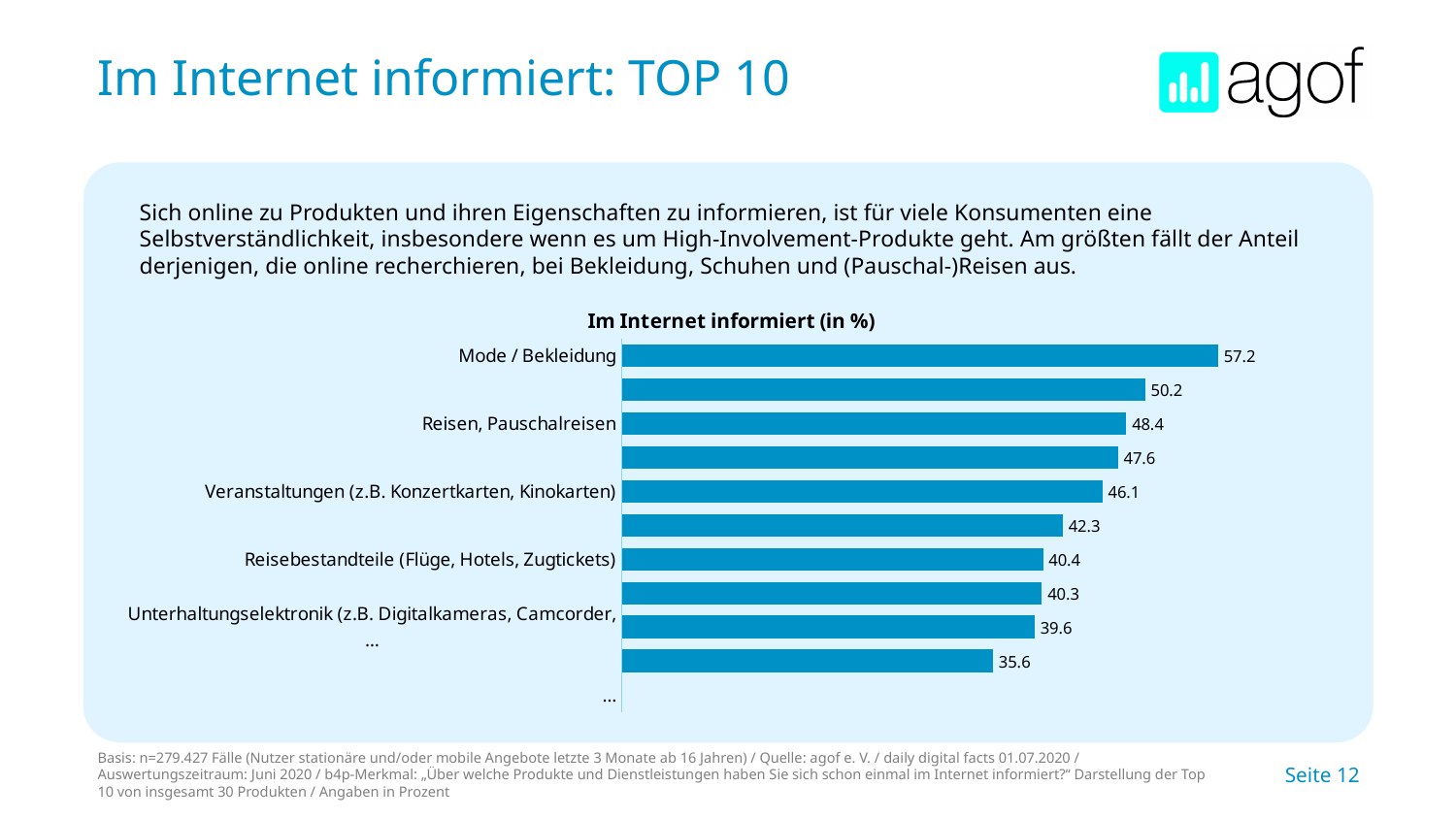
What is the lowest value shown in the chart? 35.6 What is the value for Reisen, Pauschalreisen? 48.4 What is the value for Veranstaltungen (z.B. Konzertkarten, Kinokarten)? 46.1 What is the difference between the values for Mode / Bekleidung and Reisen, Pauschalreisen? 8.8 What is the value for Reisebestandteile (Flüge, Hotels, Zugtickets)? 40.4 What is the difference between the values for Veranstaltungen (z.B. Konzertkarten, Kinokarten) and Reisebestandteile (Flüge, Hotels, Zugtickets)? 5.7 What is the title of the chart? Im Internet informiert (in %) What is the value for Unterhaltungselektronik (z.B. Digitalkameras, Camcorder, ...)? 39.6 What is the value for Mode / Bekleidung? 57.2 Which category has the highest value in the chart? Mode / Bekleidung What kind of chart is shown on the slide? Bar chart Which is larger, the value for Reisen, Pauschalreisen or the value for Reisebestandteile (Flüge, Hotels, Zugtickets)? Reisen, Pauschalreisen